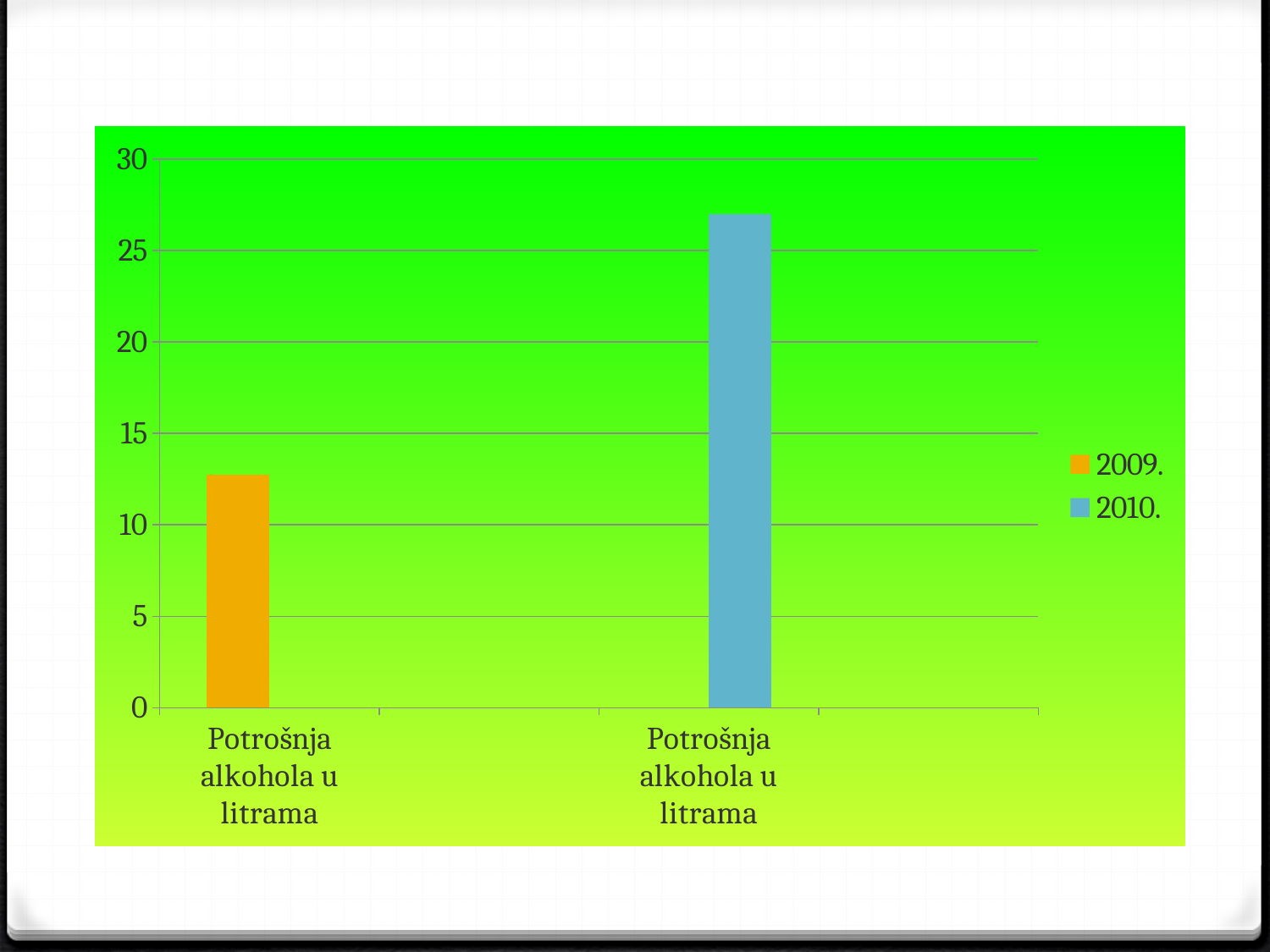
Is the value for the 2009. bar greater or less than 10? greater What colour is the bar for the 2010. series? blue Is the value for the 2010. bar greater or less than 25? greater What are the two entries listed in the chart legend? 2009. and 2010. How many bars are plotted in the chart? 2 What kind of chart is shown on the slide? bar chart Is the value for the 2010. bar greater or less than 30? less Which series has the shortest bar in the chart? 2009. Which series has the taller bar, 2009. or 2010.? 2010. How many series does the legend list? 2 Which series has the highest bar in the chart? 2010.